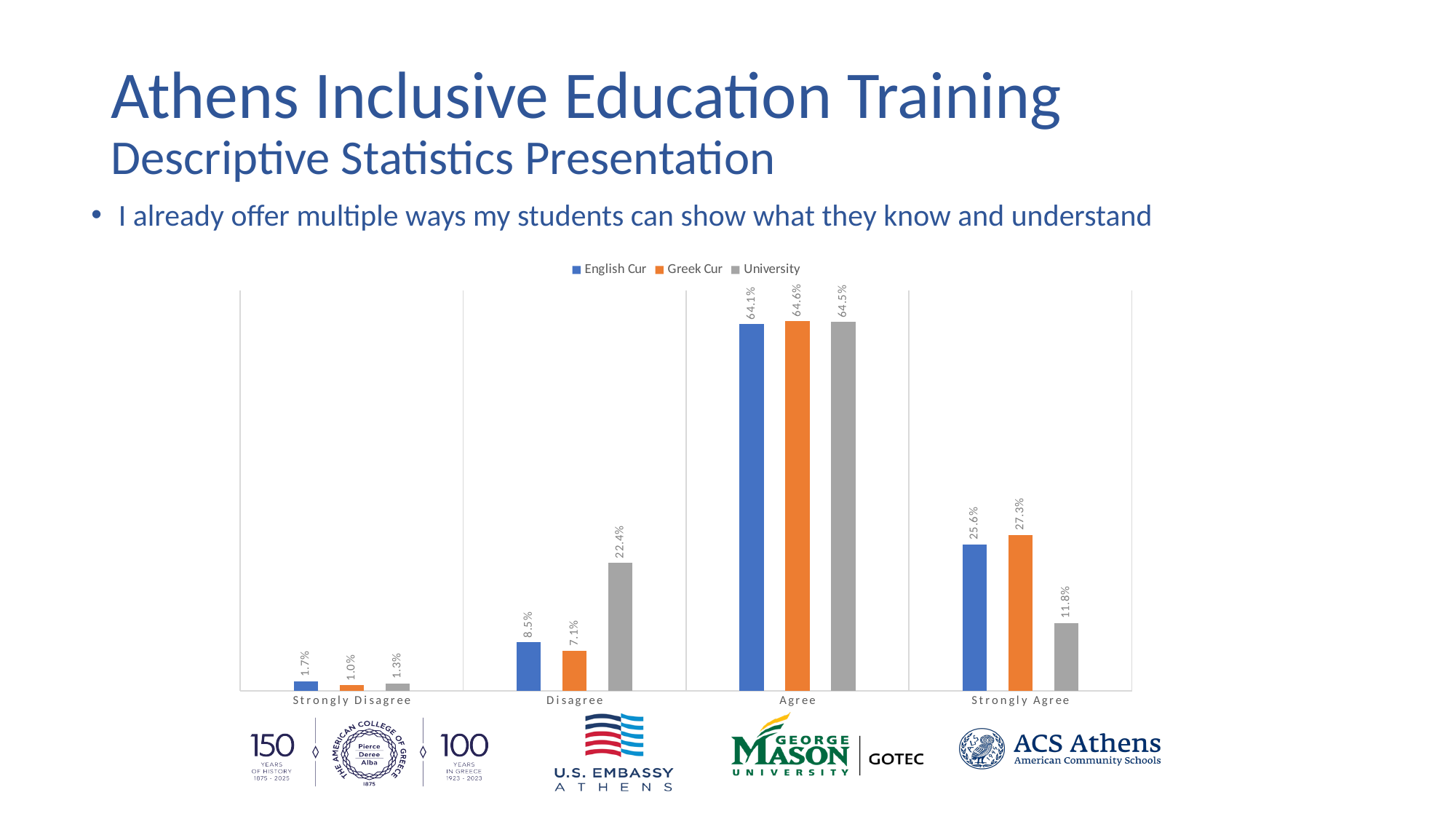
Which category has the highest value for the University series? Agree What is the value for University in the Disagree category? 22.4% How many series does the legend list? 3 How many response categories are shown on the x axis? 4 What is the value for English Cur in the Strongly Agree category? 25.6% Which category has the lowest value for the Greek Cur series? Strongly Disagree What is the difference between the University and English Cur values in the Disagree category? 13.9% In the Strongly Agree category, which is larger: the Greek Cur value or the University value? Greek Cur What is the difference between the Greek Cur and English Cur values in the Strongly Agree category? 1.7% What kind of chart is shown on the slide? Bar chart What is the value for Greek Cur in the Agree category? 64.6% Which series is shown in orange in the legend? Greek Cur